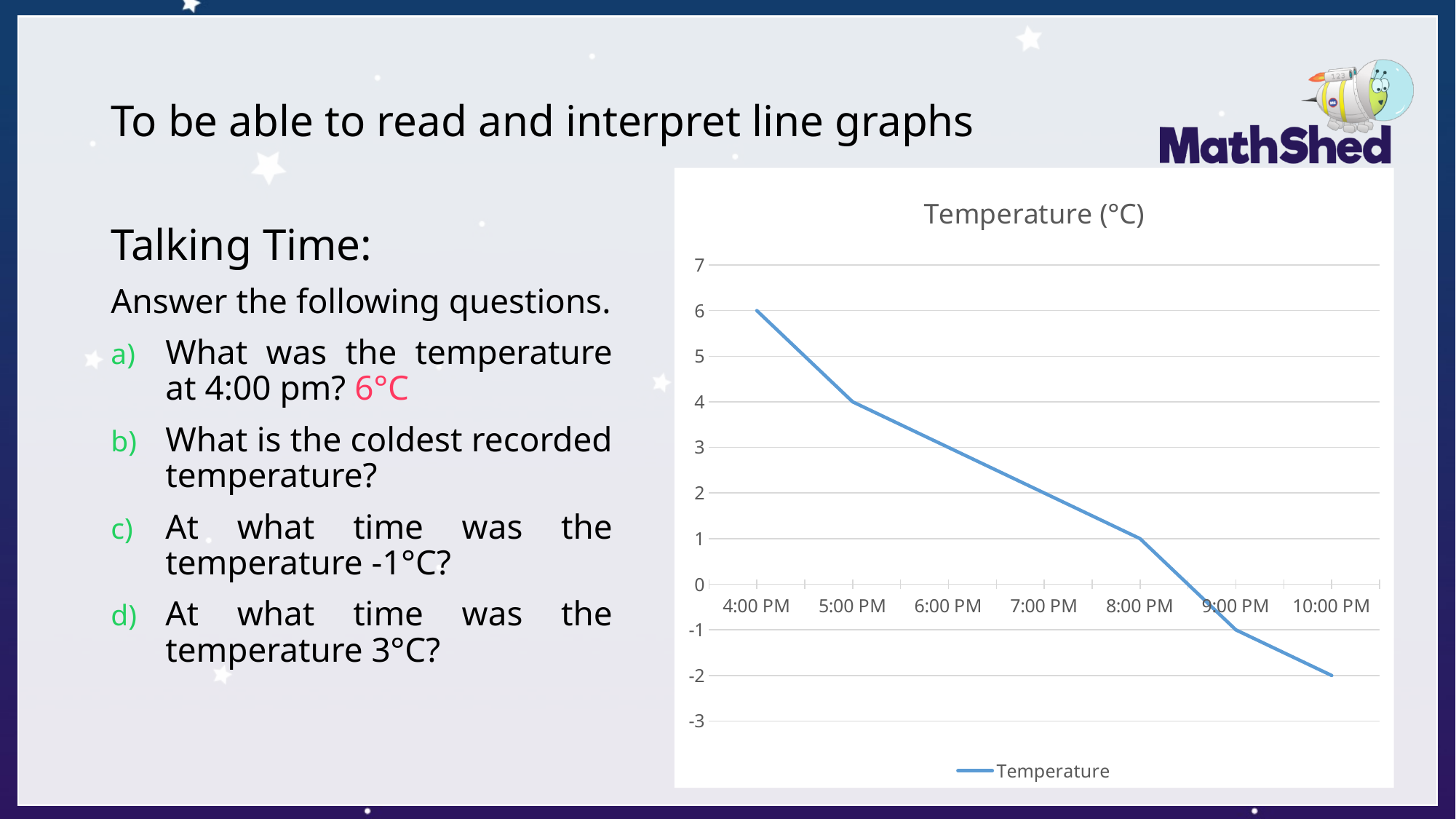
What was the temperature at 10:00 PM? -2 At which time was the temperature lowest? 10:00 PM At which time was the temperature highest? 4:00 PM How many time points are plotted on the chart? 7 What is the difference between the temperature at 4:00 PM and at 8:00 PM? 5 What was the temperature at 4:00 PM? 6 How many series does the legend list? 1 Does the temperature rise or fall from 4:00 PM to 10:00 PM? fall What is the title of the chart? Temperature (°C) What type of chart is shown on the slide? line chart What was the temperature at 5:00 PM? 4 What was the temperature at 8:00 PM? 1